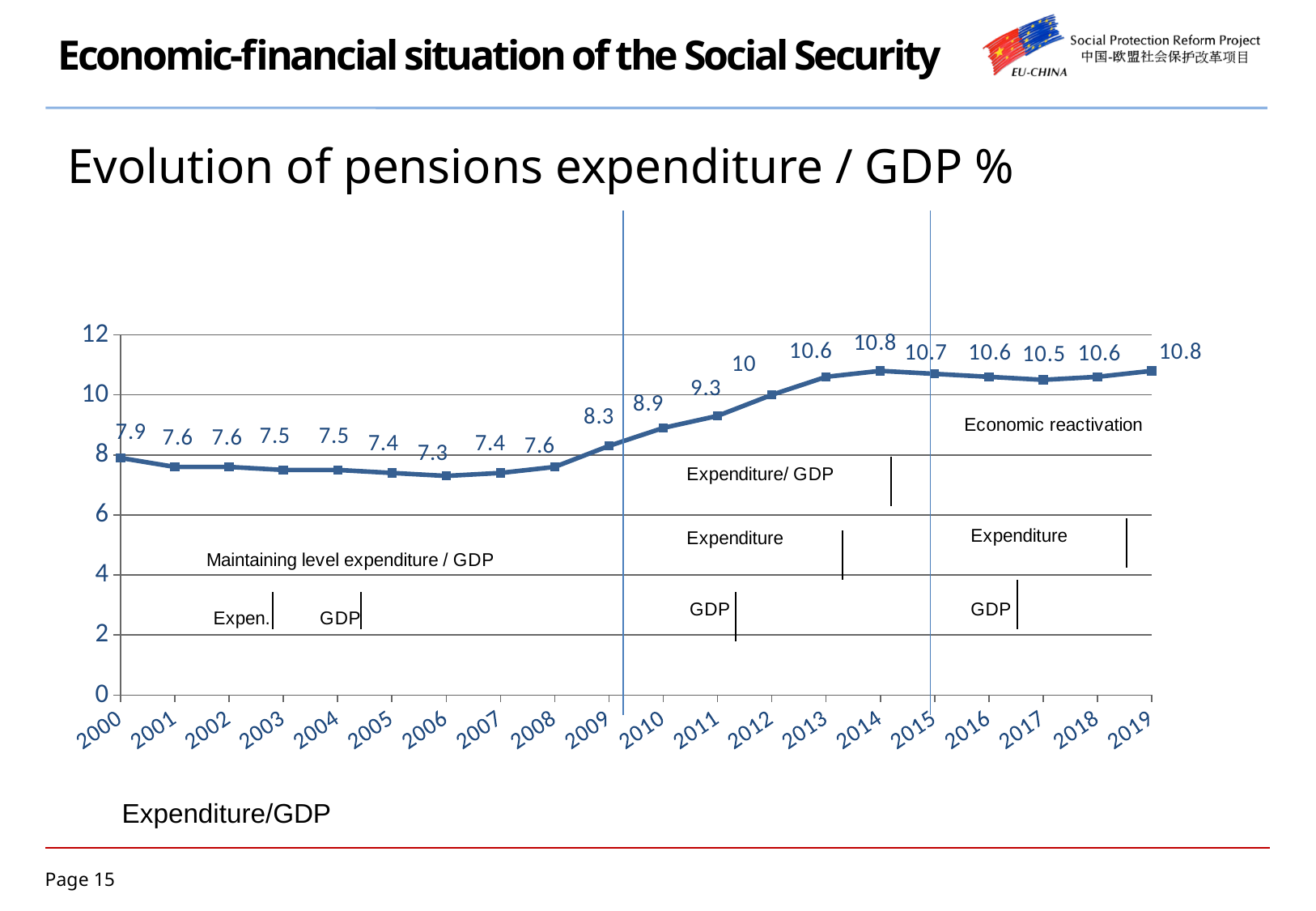
What is the difference between the values for 2014 and 2009? 2.5 Is the value for 2013 greater or less than 10? greater What kind of chart is shown on the slide? line chart Which year has the lowest pensions expenditure / GDP value? 2006 Which year has a higher value, 2011 or 2017? 2017 What is the pensions expenditure / GDP value for 2006? 7.3 Does the value rise or fall from 2008 to 2014? rise What is the difference between the values for 2010 and 2000? 1 What is the pensions expenditure / GDP value for 2012? 10 How many years are plotted on the chart? 20 What is the pensions expenditure / GDP value for 2019? 10.8 What is the pensions expenditure / GDP value for 2000? 7.9